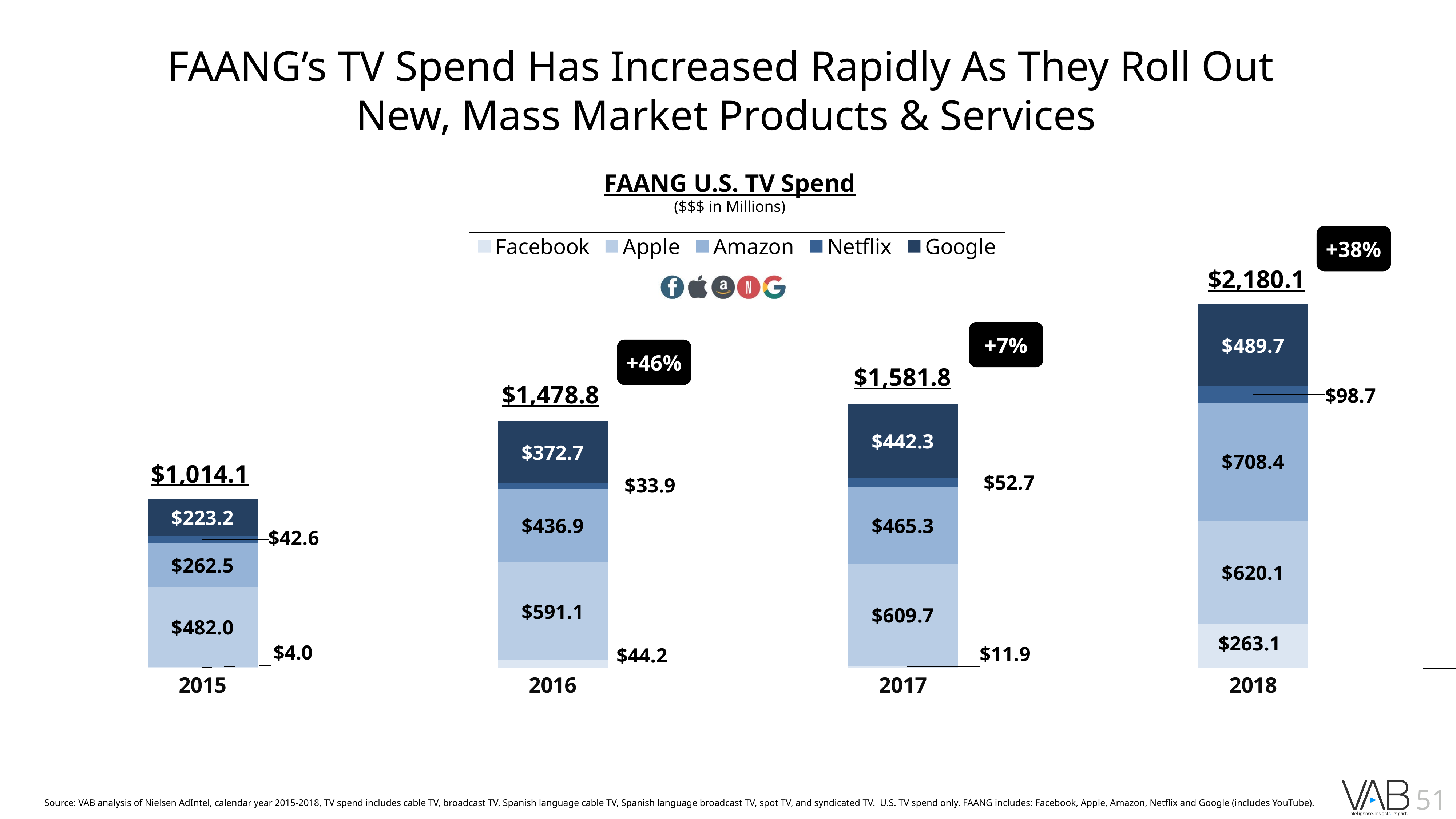
What was Google's U.S. TV spend in 2018? $489.7 What was Netflix's U.S. TV spend in 2015? $42.6 In 2018, which was larger: Amazon's spend or Apple's spend? Amazon How many series does the legend list? 5 What was Apple's U.S. TV spend in 2016? $591.1 What type of chart is shown on the slide? Stacked bar chart What is the total FAANG U.S. TV spend for 2017? $1,581.8 How many years are shown on the x axis? 4 What percentage growth label is shown for 2016? +46% Which year has the lowest total FAANG U.S. TV spend? 2015 Which year has the highest total FAANG U.S. TV spend? 2018 What is the difference between Amazon's spend in 2018 and in 2017? $243.1